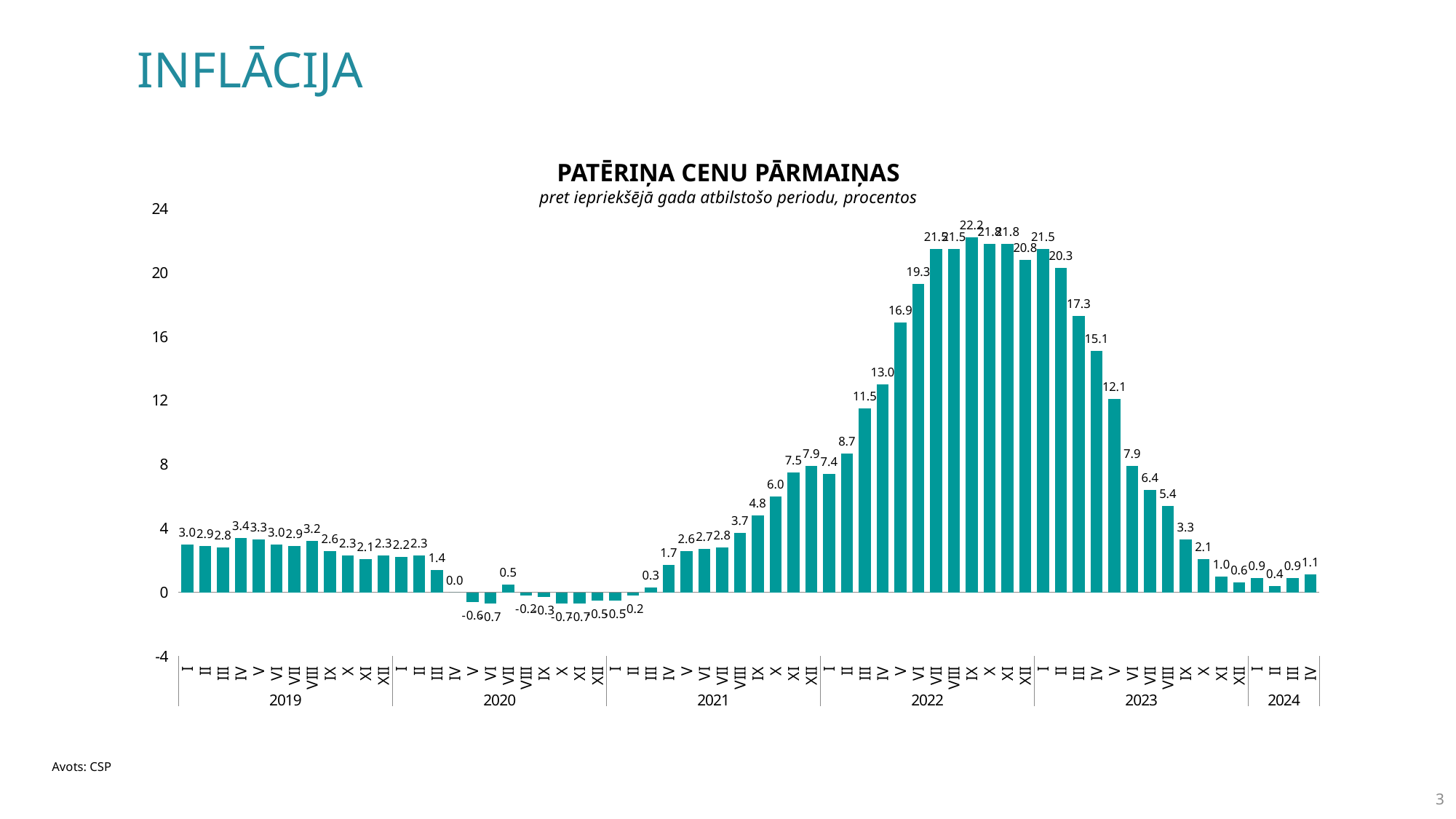
What kind of chart is shown on the slide? bar chart Is the value for IV 2023 greater or less than 12? greater Do the values rise or fall from I 2023 to XII 2023? fall What is the difference between the values for IV 2022 and III 2022? 1.5 Which month has the highest value in the chart? IX 2022 What is the highest value shown in the chart? 22.2 What is the value for IV 2024? 1.1 Which is larger, the value for VI 2023 or the value for VII 2023? VI 2023 What is the value for V 2022? 16.9 What is the value for VII 2020? 0.5 What is the value for III 2023? 17.3 What is the title of the chart? PATĒRIŅA CENU PĀRMAIŅAS